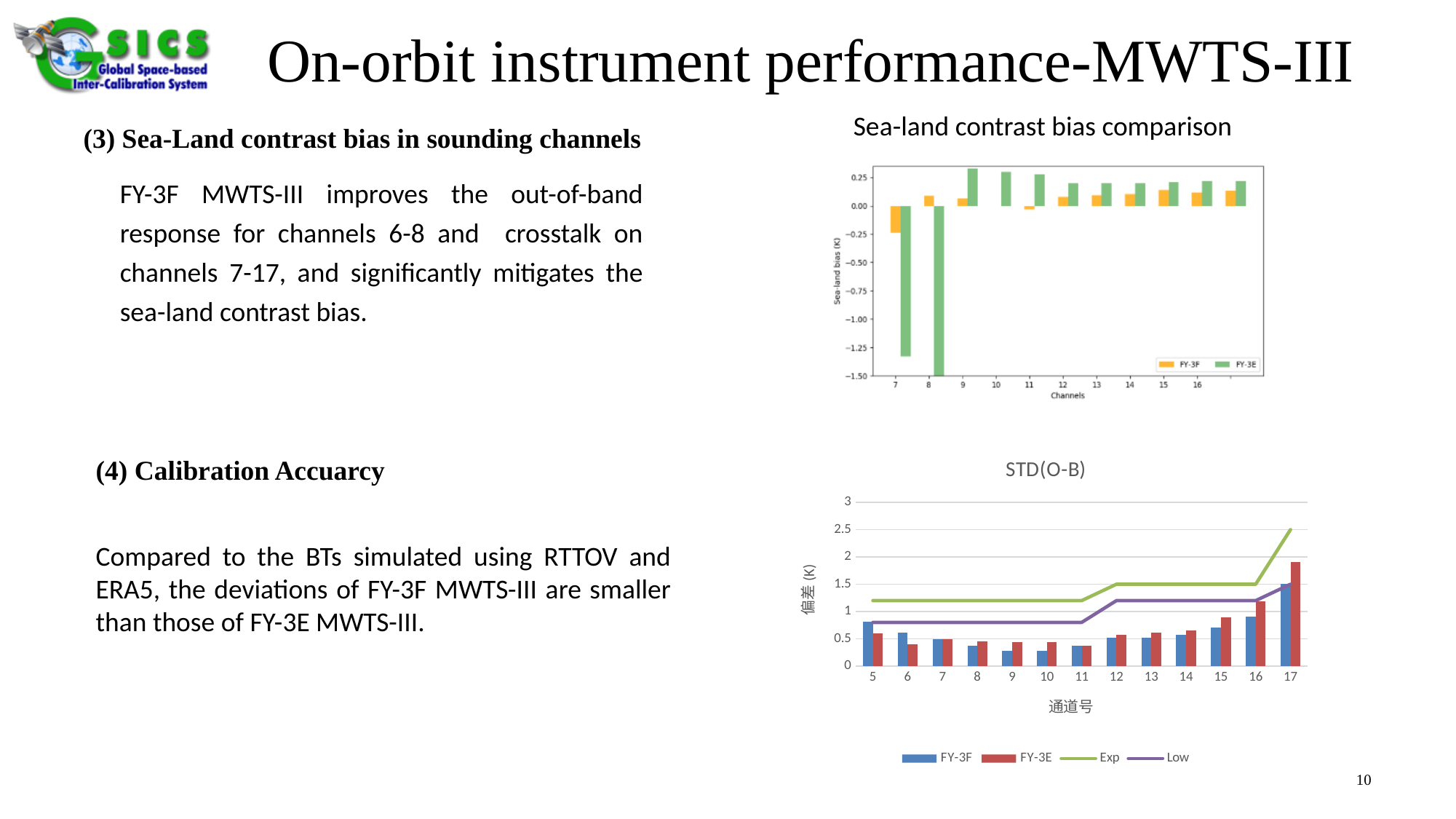
In the 'Sea-land contrast bias comparison' chart, at channel 9, which series has the larger value, FY-3F or FY-3E? FY-3E In the 'Sea-land contrast bias comparison' chart, how many series does the legend list? 2 In the 'STD(O-B)' chart, how many series does the legend list? 4 What type of chart is the 'Sea-land contrast bias comparison' chart? bar chart In the 'Sea-land contrast bias comparison' chart, is the FY-3E value for channel 9 greater or less than 0.25? greater In the 'STD(O-B)' chart, is the Exp value for channel 17 greater or less than 2? greater In the 'STD(O-B)' chart, at channel 5, which series has the larger value, FY-3F or FY-3E? FY-3F In the 'Sea-land contrast bias comparison' chart, which channel has the lowest FY-3E value? 8 In the 'Sea-land contrast bias comparison' chart, is the FY-3E value for channel 7 greater or less than -1.00? less In the 'STD(O-B)' chart, how many channels are shown on the x axis? 13 In the 'STD(O-B)' chart, which channel has the highest FY-3E value? 17